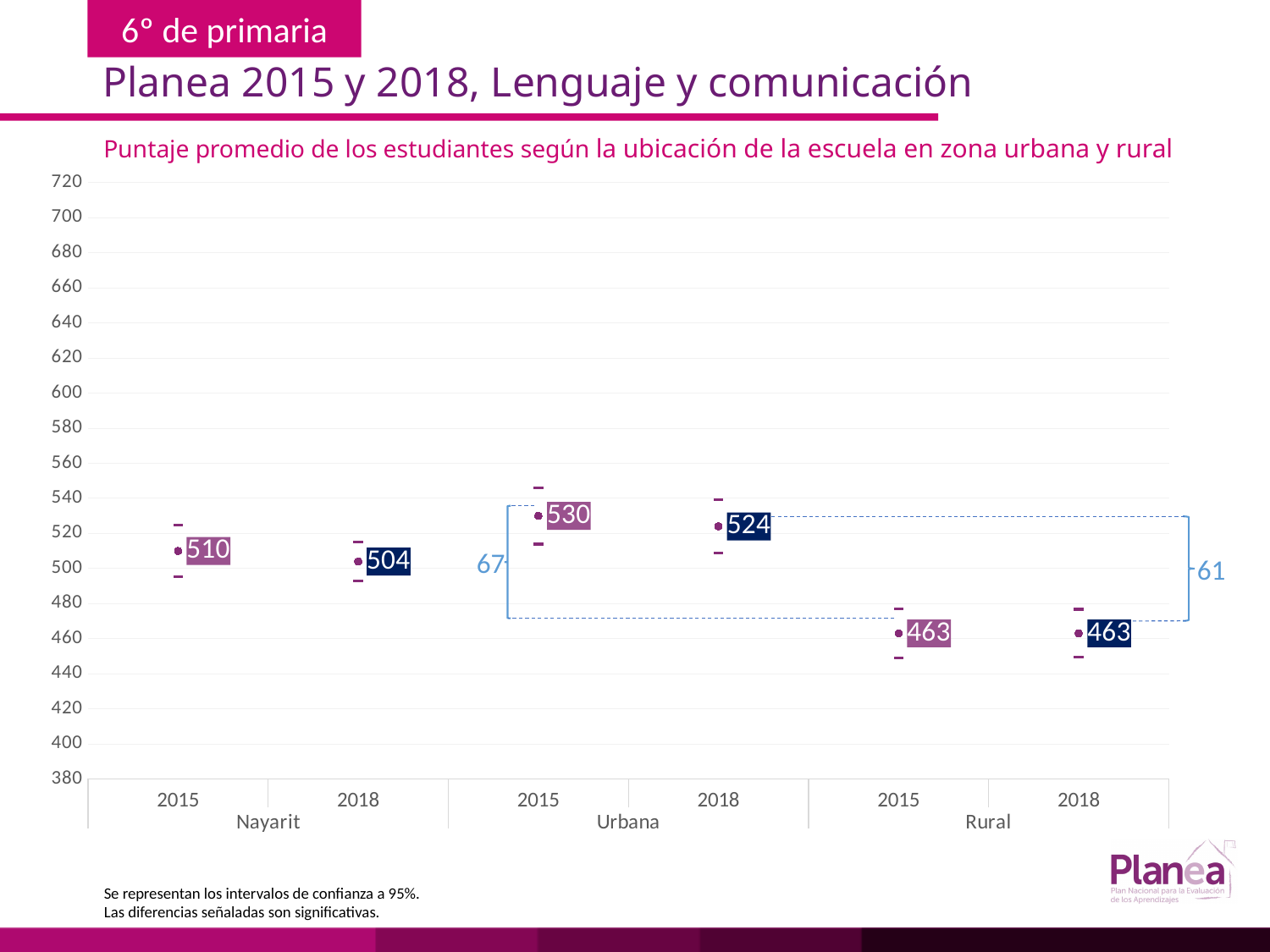
What is the difference between the Urbana 2015 score and the Rural 2015 score? 67 How did the Urbana score change from 2015 to 2018? It fell (530 to 524) What is the average score for Urbana schools in 2015? 530 Which is larger, the Nayarit 2015 score or the Nayarit 2018 score? Nayarit 2015 Is the Rural 2015 score greater or less than 480? less What is the average score for Rural schools in 2018? 463 How many data points are plotted on the chart? 6 What is the subtitle of the chart? Puntaje promedio de los estudiantes según la ubicación de la escuela en zona urbana y rural Which group and year has the highest average score? Urbana 2015 What is the average score for Nayarit in 2018? 504 What is the difference between the Urbana 2018 score and the Rural 2018 score? 61 What is the average score for Nayarit in 2015? 510